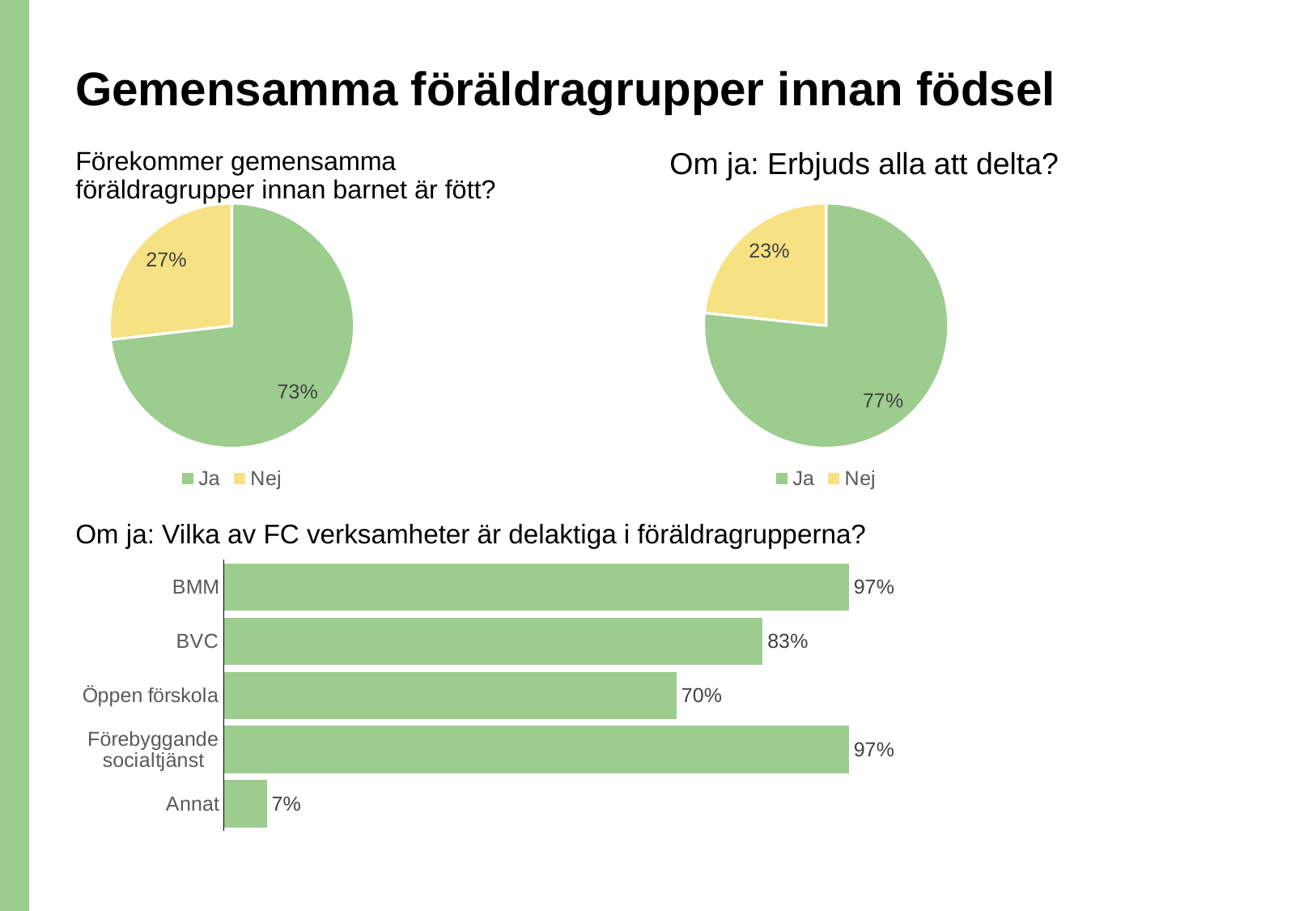
What kind of chart is the chart at the bottom of the slide? Bar chart In the pie chart titled 'Om ja: Erbjuds alla att delta?', what share is 'Ja'? 77% In the pie chart titled 'Om ja: Erbjuds alla att delta?', what share is 'Nej'? 23% In the bar chart titled 'Om ja: Vilka av FC verksamheter är delaktiga i föräldragrupperna?', what is the value for BVC? 83% In the pie chart titled 'Förekommer gemensamma föräldragrupper innan barnet är fött?', what share is 'Nej'? 27% In the pie chart titled 'Om ja: Erbjuds alla att delta?', what is the difference between the 'Ja' and 'Nej' shares? 54% In the bar chart titled 'Om ja: Vilka av FC verksamheter är delaktiga i föräldragrupperna?', which category has the lowest value? Annat In the bar chart titled 'Om ja: Vilka av FC verksamheter är delaktiga i föräldragrupperna?', what is the value for Öppen förskola? 70% In the bar chart titled 'Om ja: Vilka av FC verksamheter är delaktiga i föräldragrupperna?', what is the difference between BVC and Öppen förskola? 13% In the bar chart titled 'Om ja: Vilka av FC verksamheter är delaktiga i föräldragrupperna?', how many categories are shown? 5 In the bar chart titled 'Om ja: Vilka av FC verksamheter är delaktiga i föräldragrupperna?', which is larger, BVC or Annat? BVC